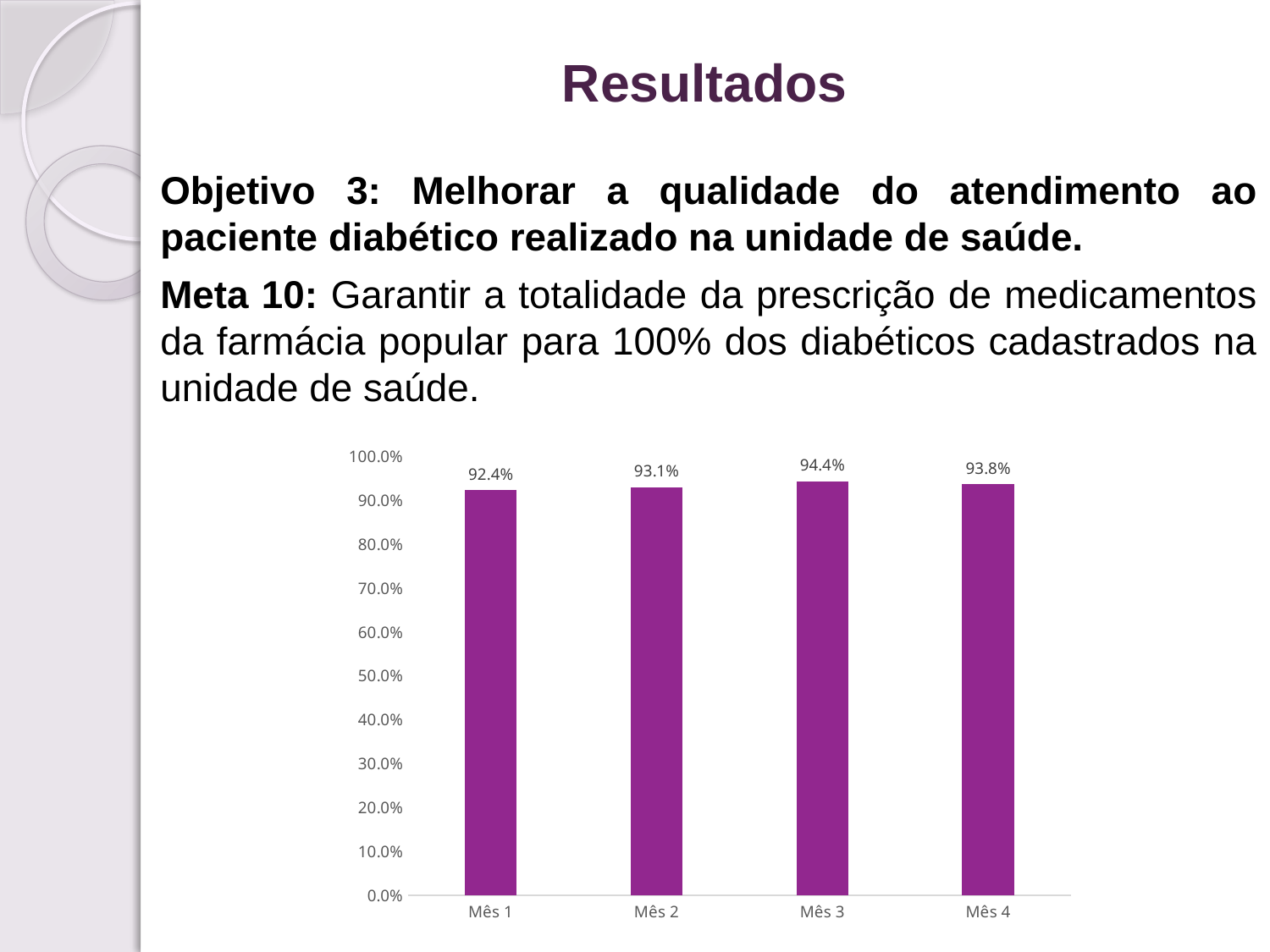
Is the value for Mês 2 greater or less than 90.0%? greater What is the difference between the values for Mês 4 and Mês 2? 0.7% Which is larger, the value for Mês 2 or the value for Mês 4? Mês 4 Which month has the highest value? Mês 3 What colour are the bars in the chart? purple What is the value for Mês 4? 93.8% What is the value for Mês 3? 94.4% What is the difference between the values for Mês 3 and Mês 1? 2.0% How many months are shown on the x axis? 4 What kind of chart is shown on the slide? bar chart What is the value for Mês 1? 92.4% Which month has the lowest value? Mês 1